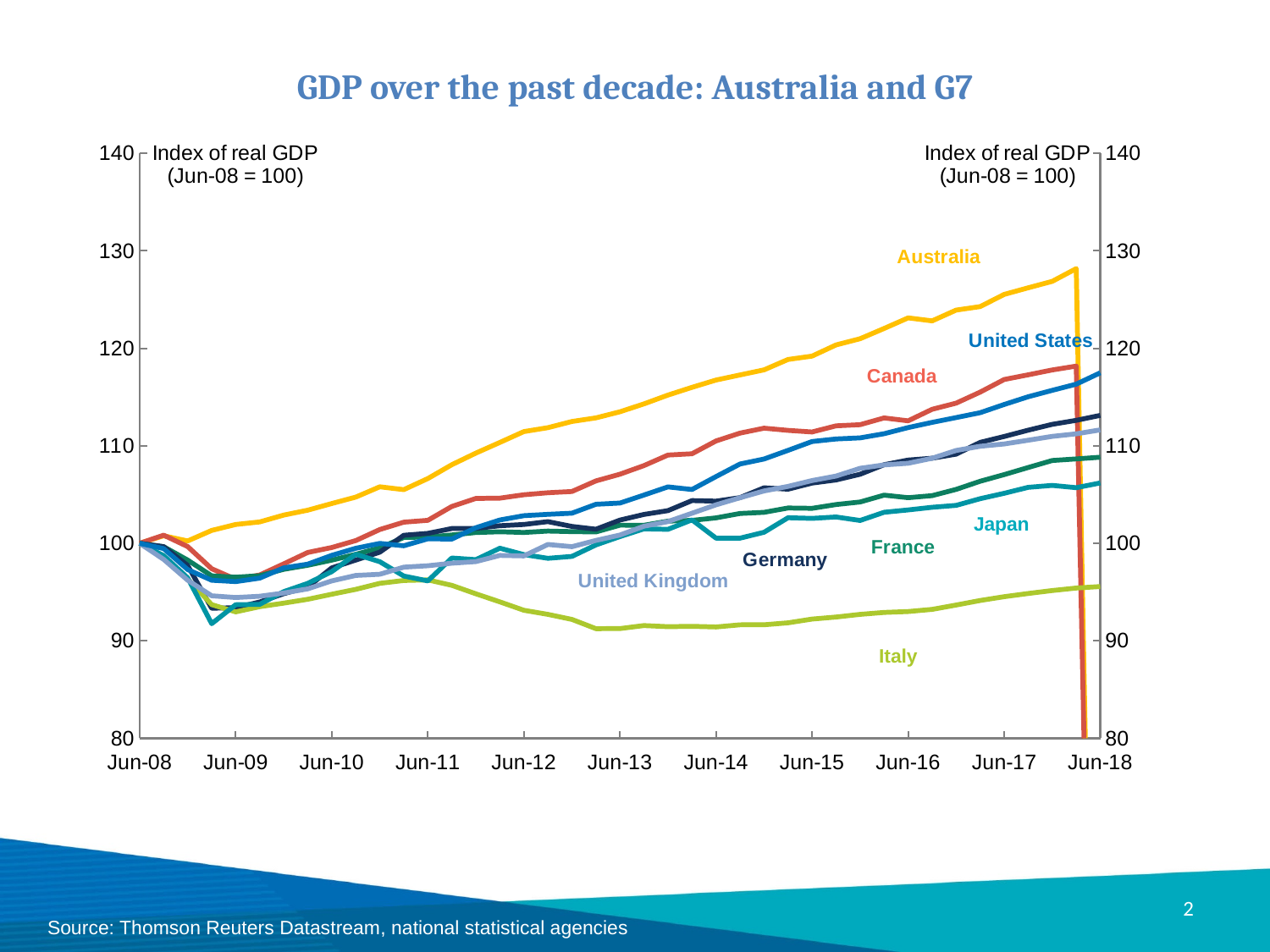
Is the value for Italy at Jun-14 greater or less than 100? less Which is higher at Jun-15, Canada or Japan? Canada Is the value for Australia at Jun-17 greater or less than 120? greater What is the index value for every country at Jun-08? 100 How many countries are plotted on the chart? 8 What is the title of the chart? GDP over the past decade: Australia and G7 Is the value for Canada at Jun-16 greater or less than 110? greater Does the line for Italy rise or fall between Jun-11 and Jun-14? Fall What kind of chart is shown on the slide? Line chart